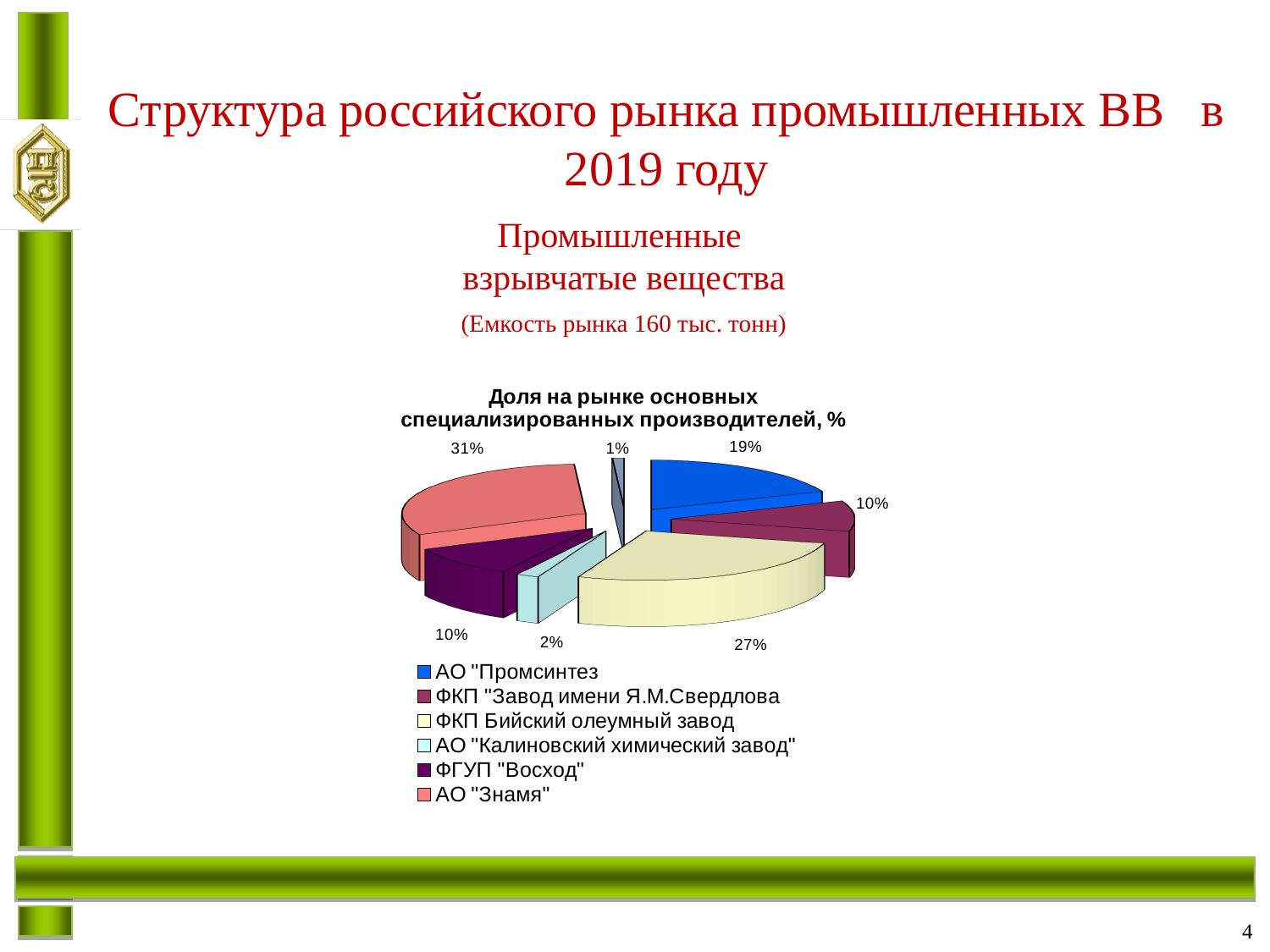
What share of the market does АО "Калиновский химический завод" hold? 2% How many entries does the legend list? 6 Which has the larger share: ФКП Бийский олеумный завод or АО "Промсинтез"? ФКП Бийский олеумный завод Which producer has the largest share of the market? АО "Знамя" How many slices does the pie chart have? 7 What share of the market does АО "Промсинтез" hold? 19% What share of the market does ФГУП "Восход" hold? 10% How many percentage points larger is the share of АО "Знамя" than that of АО "Промсинтез"? 12 What kind of chart is shown on the slide? Pie chart What is the title of the pie chart? Доля на рынке основных специализированных производителей, % What share of the market does ФКП Бийский олеумный завод hold? 27% What share of the market does АО "Знамя" hold? 31%